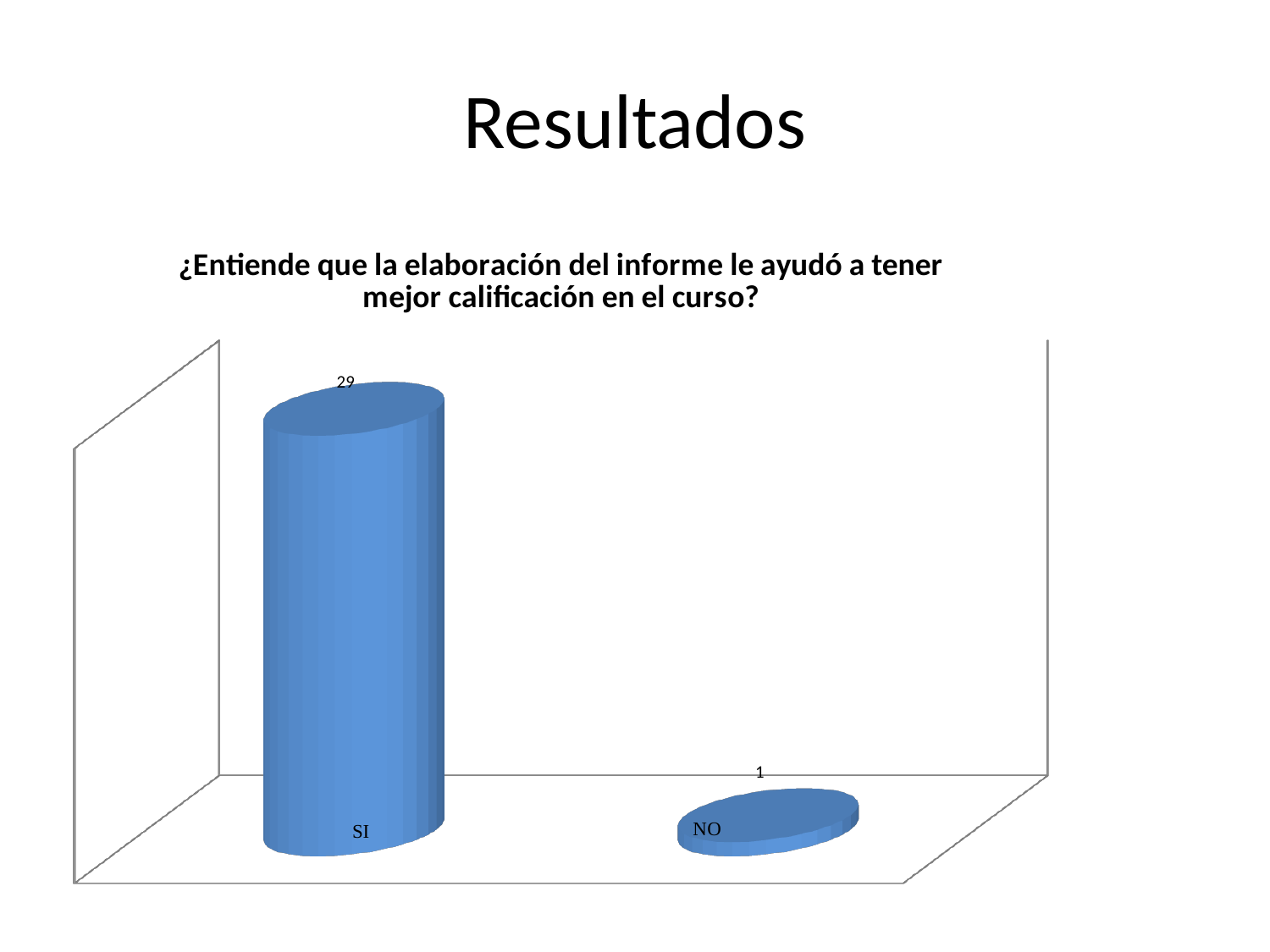
Which category has the highest value? SI What kind of chart is shown on the slide? Bar chart How many categories are shown in the chart? 2 What is the difference between the values for SI and NO? 28 Which category has the lowest value? NO What is the value for SI? 29 Which is larger, the value for SI or the value for NO? SI What colour are the bars in the chart? Blue What is the value for NO? 1 What is the total of the values for SI and NO? 30 What is the title of the chart? ¿Entiende que la elaboración del informe le ayudó a tener mejor calificación en el curso?